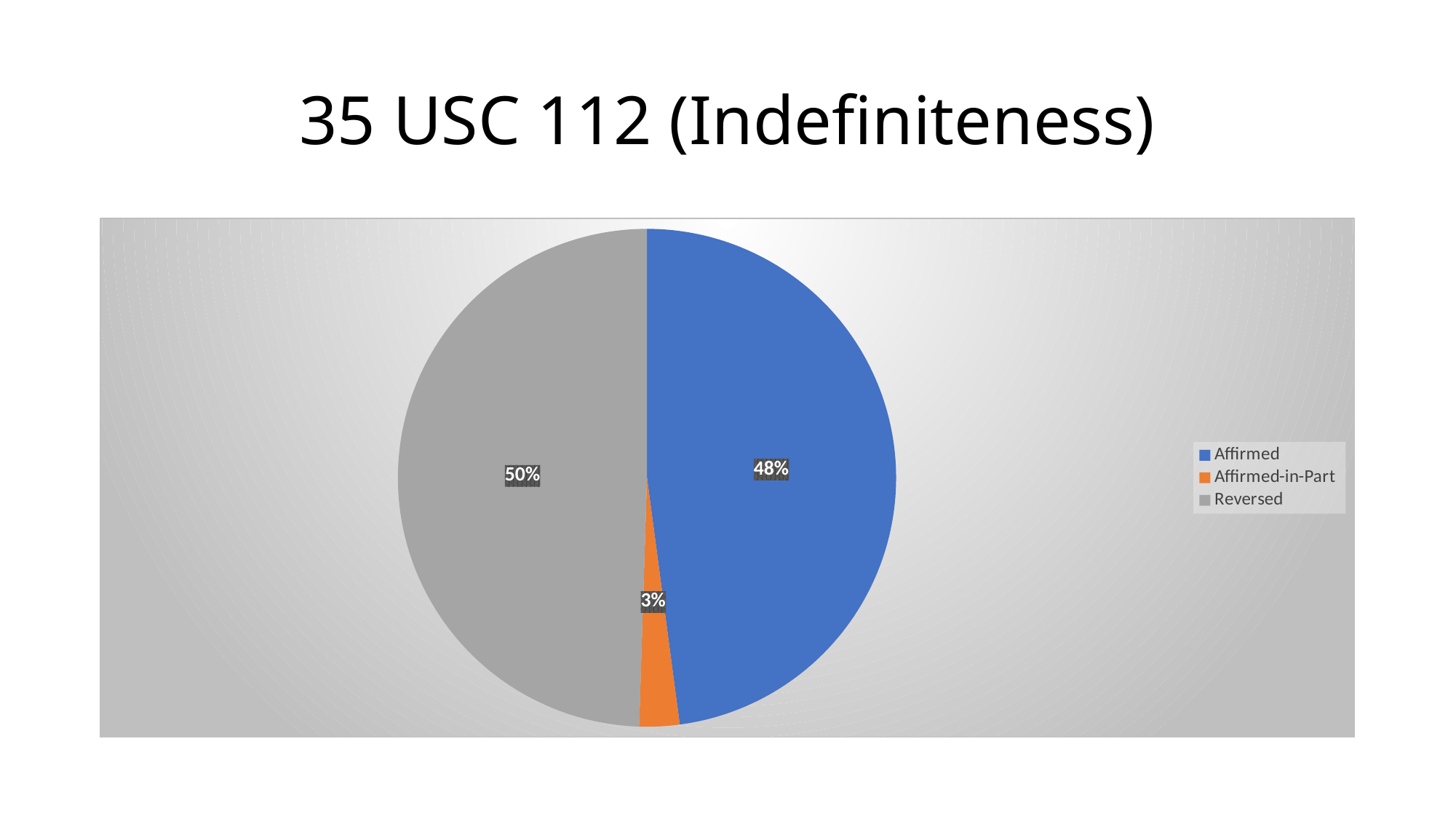
What is the title of the slide? 35 USC 112 (Indefiniteness) Which is larger, the Affirmed slice or the Affirmed-in-Part slice? Affirmed What share of the pie is labelled Affirmed? 48% What colour is the Reversed slice? grey How many categories does the legend list? 3 What share of the pie is labelled Affirmed-in-Part? 3% What share of the pie is labelled Reversed? 50% What kind of chart is shown on the slide? pie chart Which category has the smallest slice of the pie? Affirmed-in-Part Which category has the largest slice of the pie? Reversed What is the difference in percentage points between the Affirmed and Affirmed-in-Part slices? 45